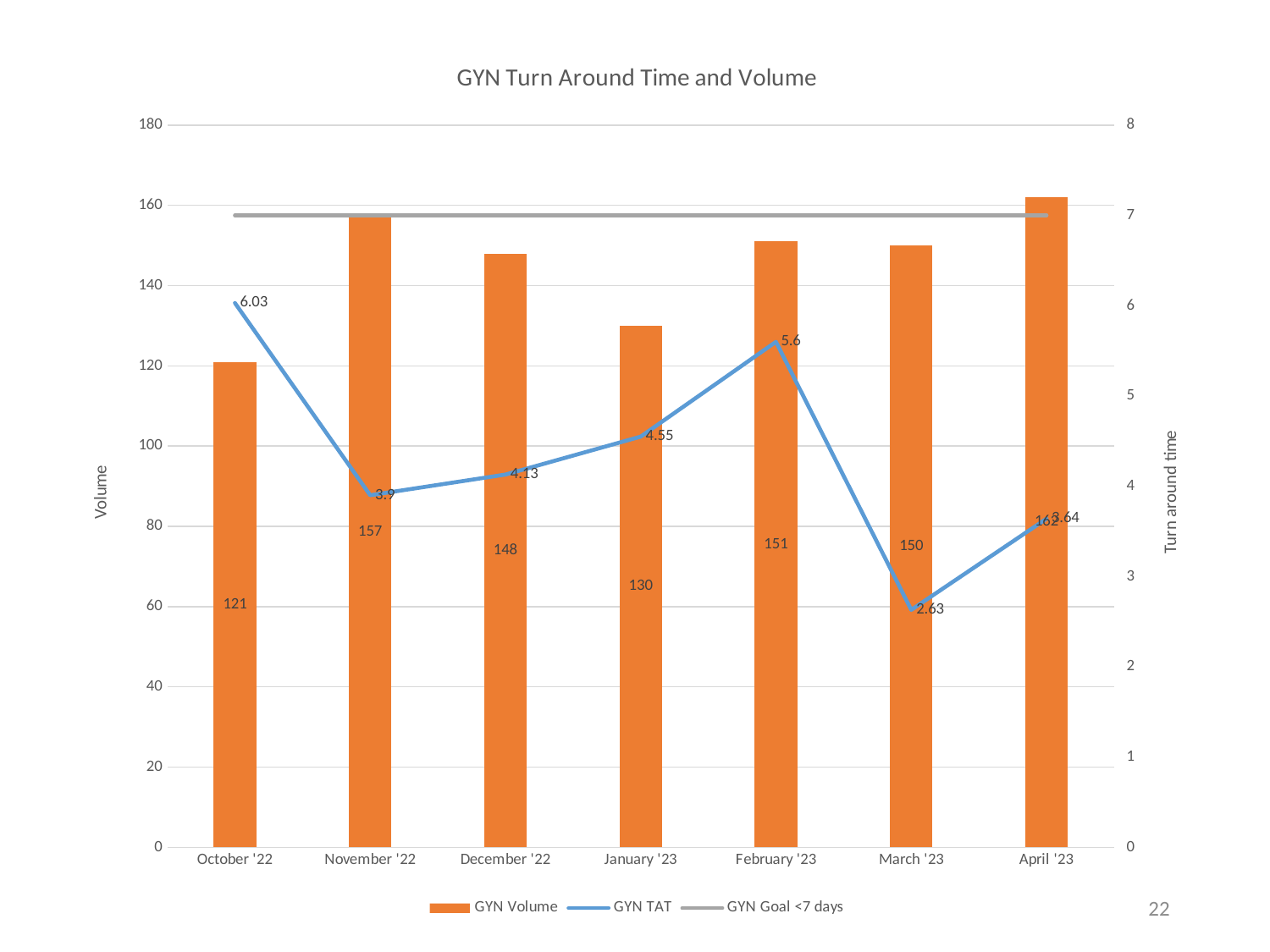
How many series does the legend list? 3 What is the difference in GYN Volume between November '22 and December '22? 9 How many months are shown on the x axis? 7 What is the GYN Volume for November '22? 157 Is the GYN Volume for April '23 greater or less than 160? greater Which month has the lowest GYN Volume? October '22 Which month has the lowest GYN TAT? March '23 What is the GYN TAT value for March '23? 2.63 Which month has the highest GYN TAT? October '22 Is the GYN TAT higher in February '23 or in January '23? February '23 What is the GYN TAT value for October '22? 6.03 What is the GYN Volume for January '23? 130